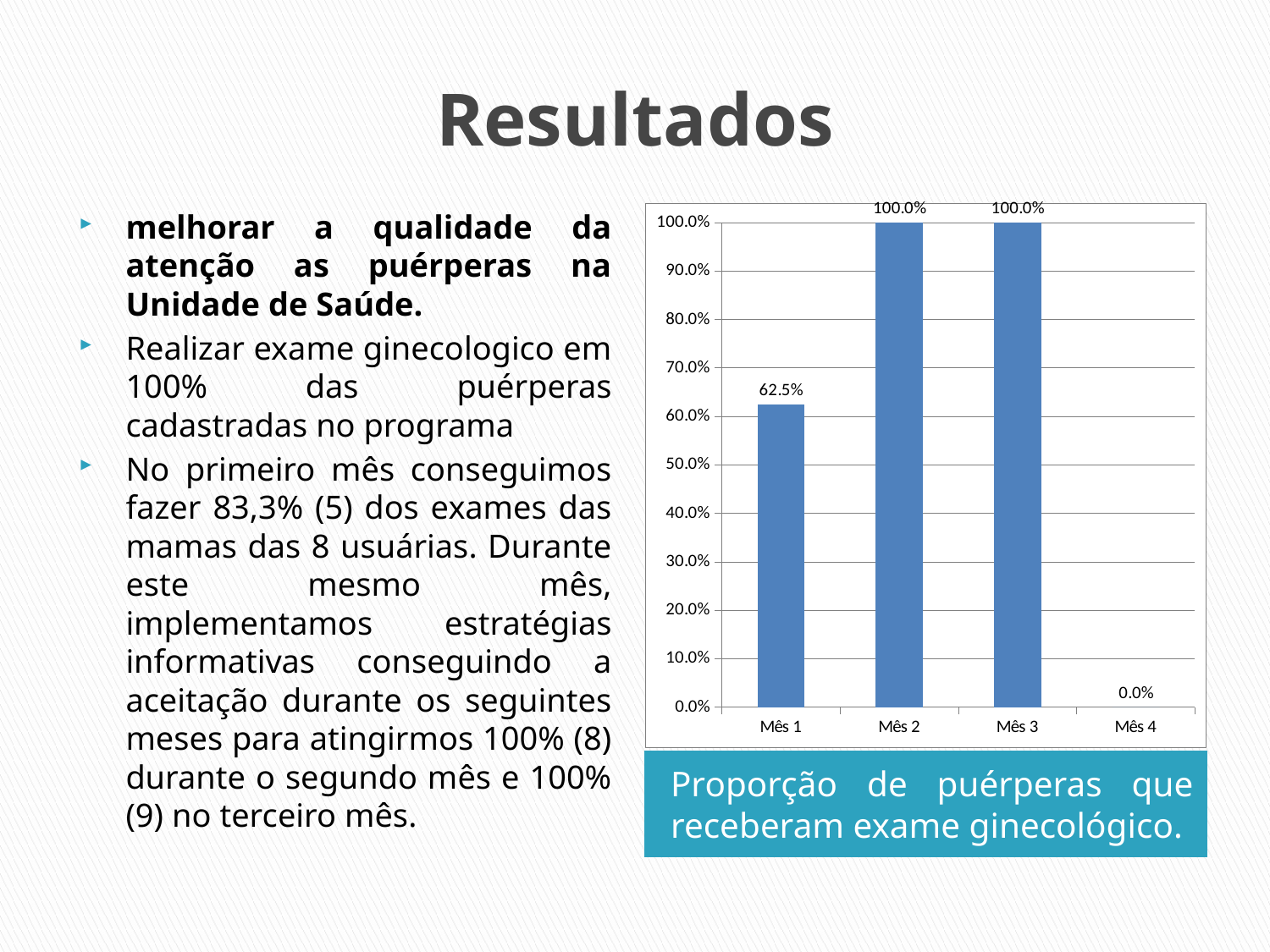
Which is larger, the value for Mês 1 or the value for Mês 3? Mês 3 What is the value for Mês 4? 0.0% What is the value for Mês 1? 62.5% What is the highest value shown on the y axis? 100.0% What is the caption below the chart? Proporção de puérperas que receberam exame ginecológico. What is the difference between the values for Mês 2 and Mês 1? 37.5% Do the values rise or fall from Mês 1 to Mês 2? Rise How many months are shown on the x axis? 4 Which month has the lowest value? Mês 4 What kind of chart is shown on the slide? Bar chart What is the value for Mês 2? 100.0% Is the value for Mês 1 greater or less than 50.0%? greater